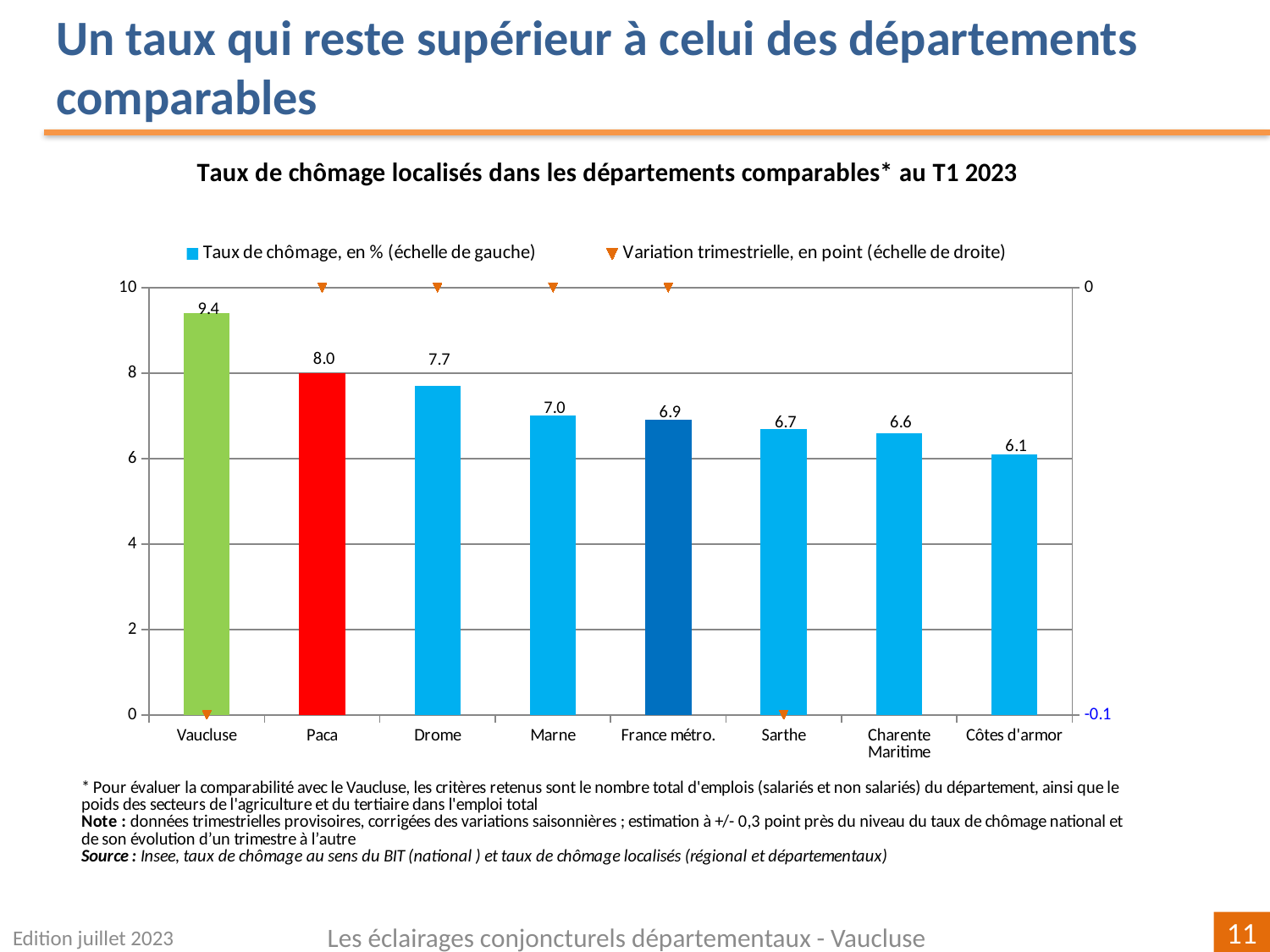
Which category has the highest unemployment rate? Vaucluse Do the unemployment rate bars rise or fall from left to right along the x axis? Fall Which category has the lowest unemployment rate? Côtes d'armor What is the unemployment rate shown for France métro.? 6.9 What kind of chart is used to show the unemployment rates? Bar chart What is the unemployment rate shown for Paca? 8.0 Which has a higher unemployment rate, Drome or Marne? Drome What is the difference between the unemployment rate of Vaucluse and that of France métro.? 2.5 How many categories (departments/areas) are shown on the x axis? 8 What is the unemployment rate (Taux de chômage) shown for Vaucluse? 9.4 How many series does the legend list? 2 What is the unemployment rate shown for Charente Maritime? 6.6